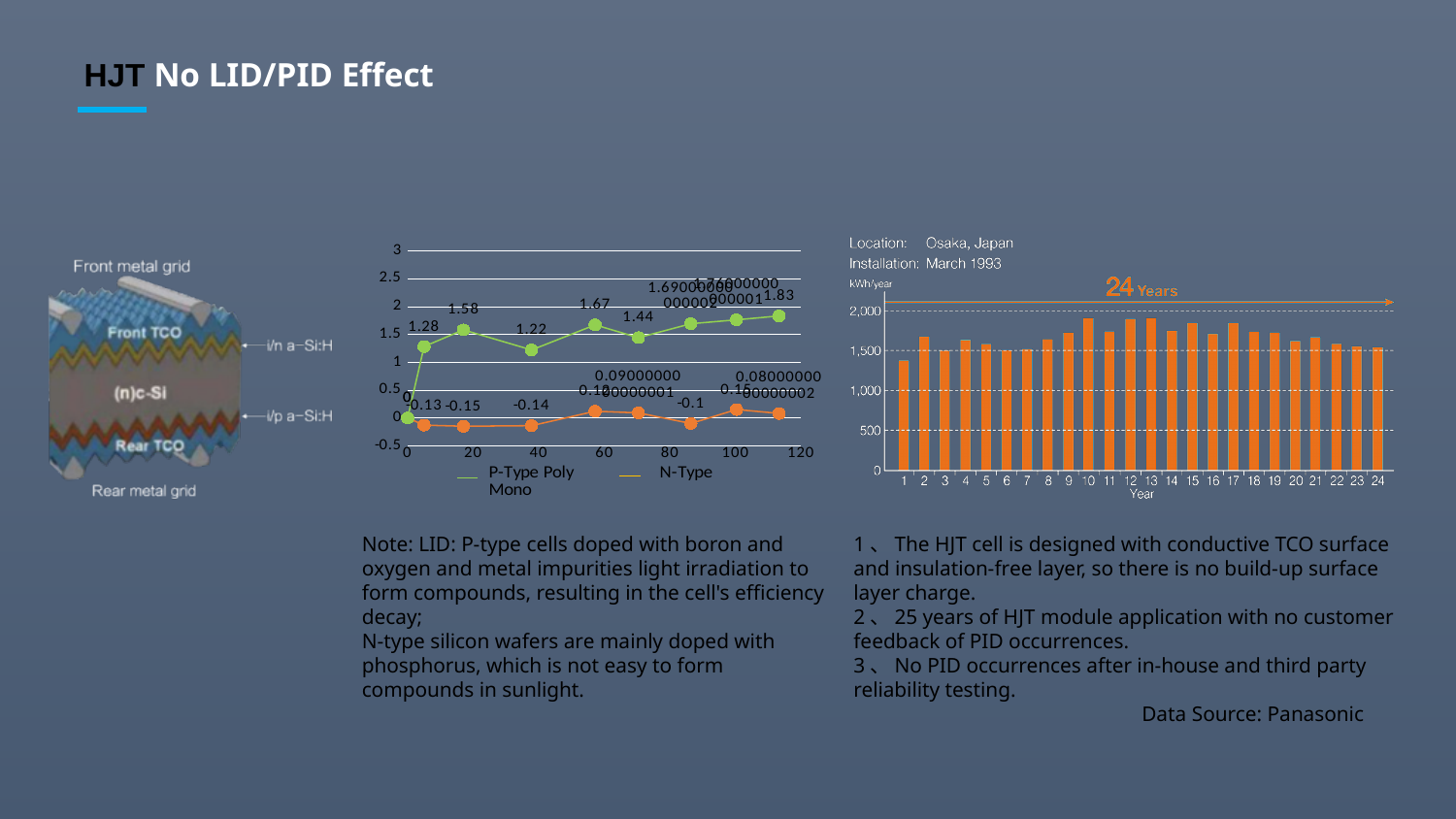
In the left line chart, what is the lowest labeled value of the N-Type series? -0.15 In the left line chart, what is the first labeled value of the P-Type Poly Mono series? 0 In the right bar chart, how many years (bars) are shown? 24 In the right bar chart, is the value for year 10 greater or less than 1,500? greater What kind of chart is the chart on the left with the P-Type Poly Mono and N-Type series? line chart In the left line chart, what is the difference between the last P-Type Poly Mono value (1.83) and the first (1.28)? 0.55 In the left line chart, what is the last labeled value of the P-Type Poly Mono series (at the right end)? 1.83 In the left line chart, how many series does the legend list? 2 In the left line chart, what are the two series named in the legend? P-Type Poly Mono and N-Type What kind of chart is the orange chart on the right showing kWh/year by year? bar chart In the left line chart, which is larger for the P-Type Poly Mono series: the second labeled value (1.58) or the third labeled value (1.22)? 1.58 In the right bar chart, is the value for year 1 greater or less than 1,500? less